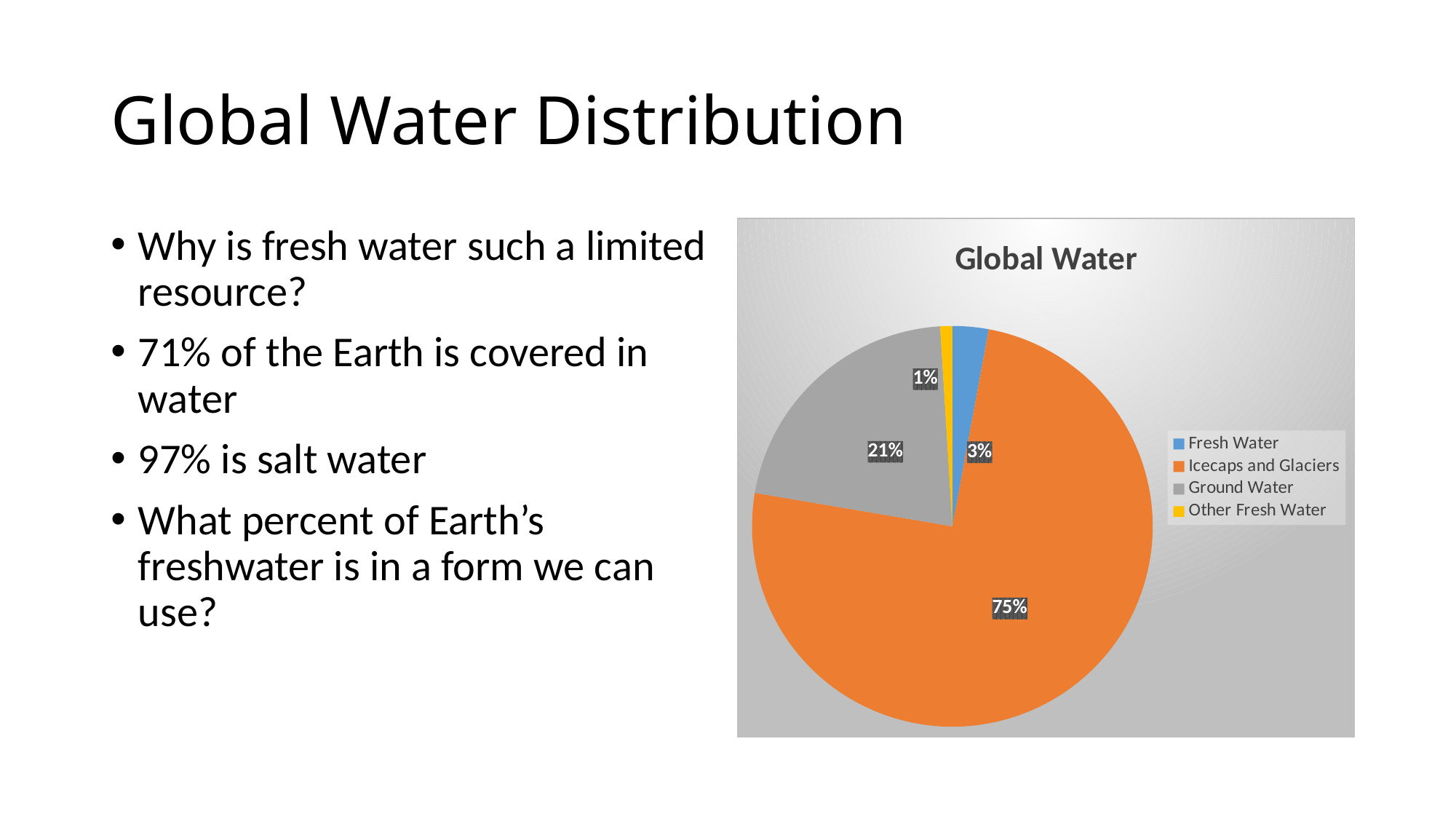
What share of the pie is Fresh Water? 3% Which category has the largest slice of the pie? Icecaps and Glaciers Which category has the smallest slice of the pie? Other Fresh Water Which is larger, the Ground Water slice or the Fresh Water slice? Ground Water What colour is the Ground Water slice? gray How many categories does the legend list? 4 What share of the pie is Ground Water? 21% What share of the pie is Icecaps and Glaciers? 75% What is the difference between the Icecaps and Glaciers share and the Ground Water share? 54% What type of chart is shown on the slide? pie chart What is the title of the chart? Global Water